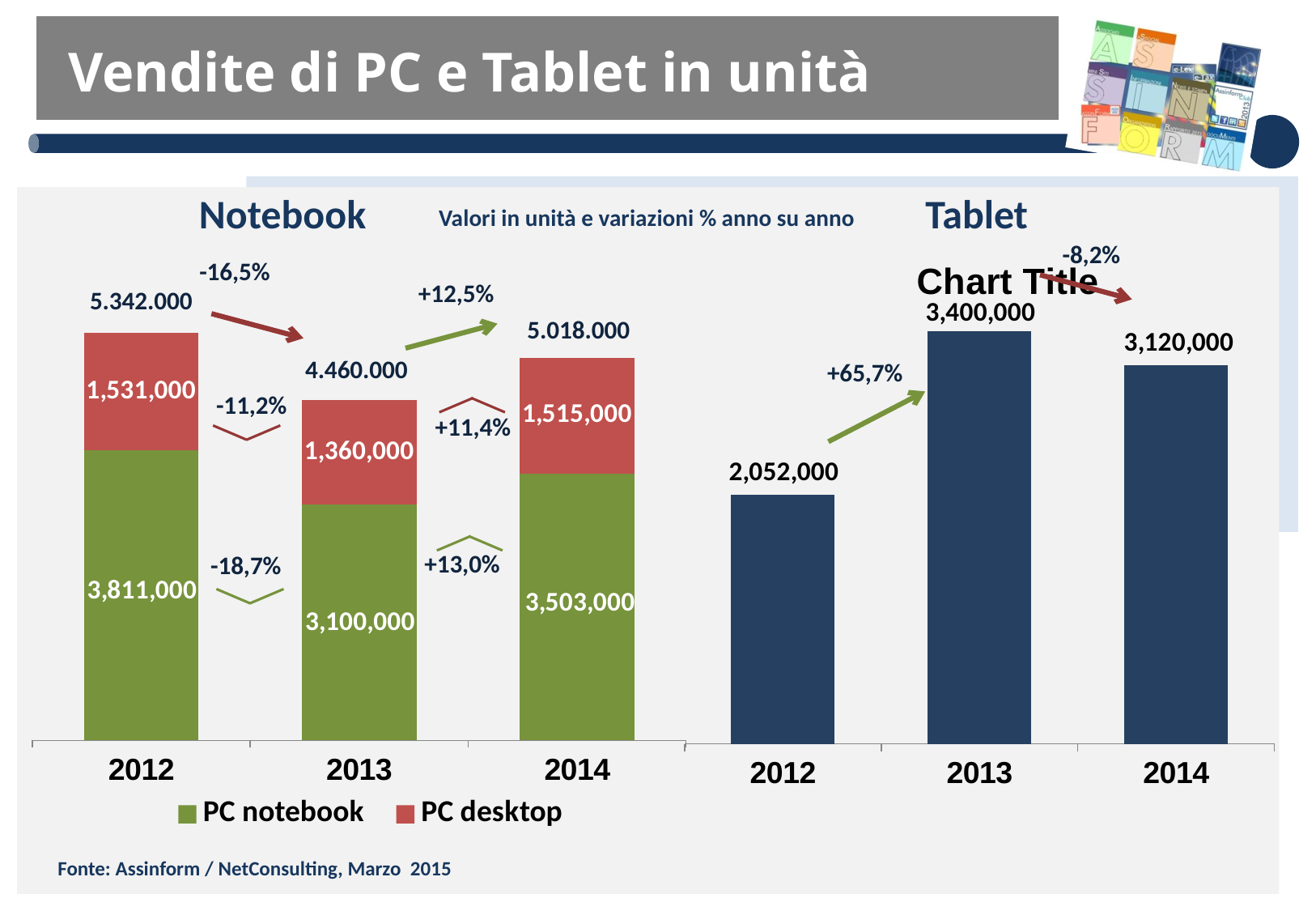
In the right chart (Tablet), how many years are shown on the x axis? 3 In the left chart (Notebook), what is the difference between the PC desktop values for 2012 and 2014? 16,000 What kind of chart is the right chart (Tablet)? Bar chart In the left chart (Notebook), how many series does the legend list? 2 In the right chart (Tablet), what is the value for 2013? 3,400,000 In the right chart (Tablet), what is the difference between the values for 2013 and 2012? 1,348,000 In the left chart (Notebook), which colour represents PC desktop? Red In the left chart (Notebook), what is the total of the stacked bar for 2014? 5.018.000 In the right chart (Tablet), which year has the highest value? 2013 In the left chart (Notebook), which year has the lowest PC notebook value? 2013 In the left chart (Notebook), what is the value for PC notebook in 2012? 3,811,000 In the left chart (Notebook), what is the value for PC desktop in 2013? 1,360,000